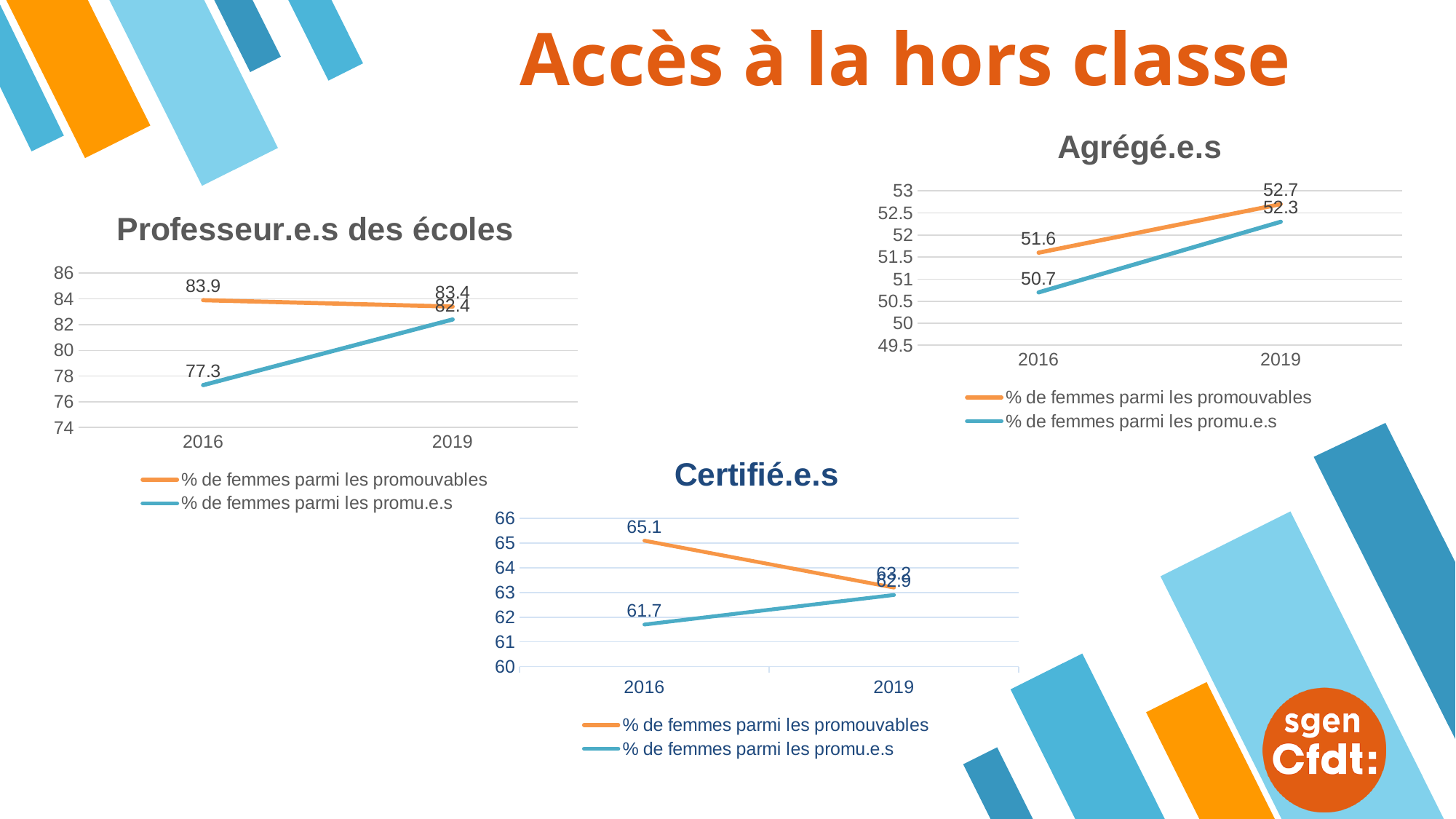
In the 'Certifié.e.s' chart, what is the value of '% de femmes parmi les promouvables' in 2016? 65.1 In the 'Agrégé.e.s' chart, does '% de femmes parmi les promu.e.s' rise or fall from 2016 to 2019? rise In the 'Professeur.e.s des écoles' chart, does '% de femmes parmi les promouvables' rise or fall from 2016 to 2019? fall In the 'Agrégé.e.s' chart, what is the value of '% de femmes parmi les promouvables' in 2016? 51.6 In the 'Agrégé.e.s' chart, what is the value of '% de femmes parmi les promu.e.s' in 2019? 52.3 What type of chart is the 'Certifié.e.s' chart? line chart In the 'Agrégé.e.s' chart, what is the difference between the two series in 2016? 0.9 In the 'Professeur.e.s des écoles' chart, what is the value of '% de femmes parmi les promu.e.s' in 2016? 77.3 How many series does the legend of the 'Certifié.e.s' chart list? 2 In the 'Certifié.e.s' chart, which series has the higher value in 2016? % de femmes parmi les promouvables In the 'Professeur.e.s des écoles' chart, what is the value of '% de femmes parmi les promouvables' in 2019? 83.4 In the 'Professeur.e.s des écoles' chart, by how much did '% de femmes parmi les promu.e.s' change between 2016 and 2019? 5.1